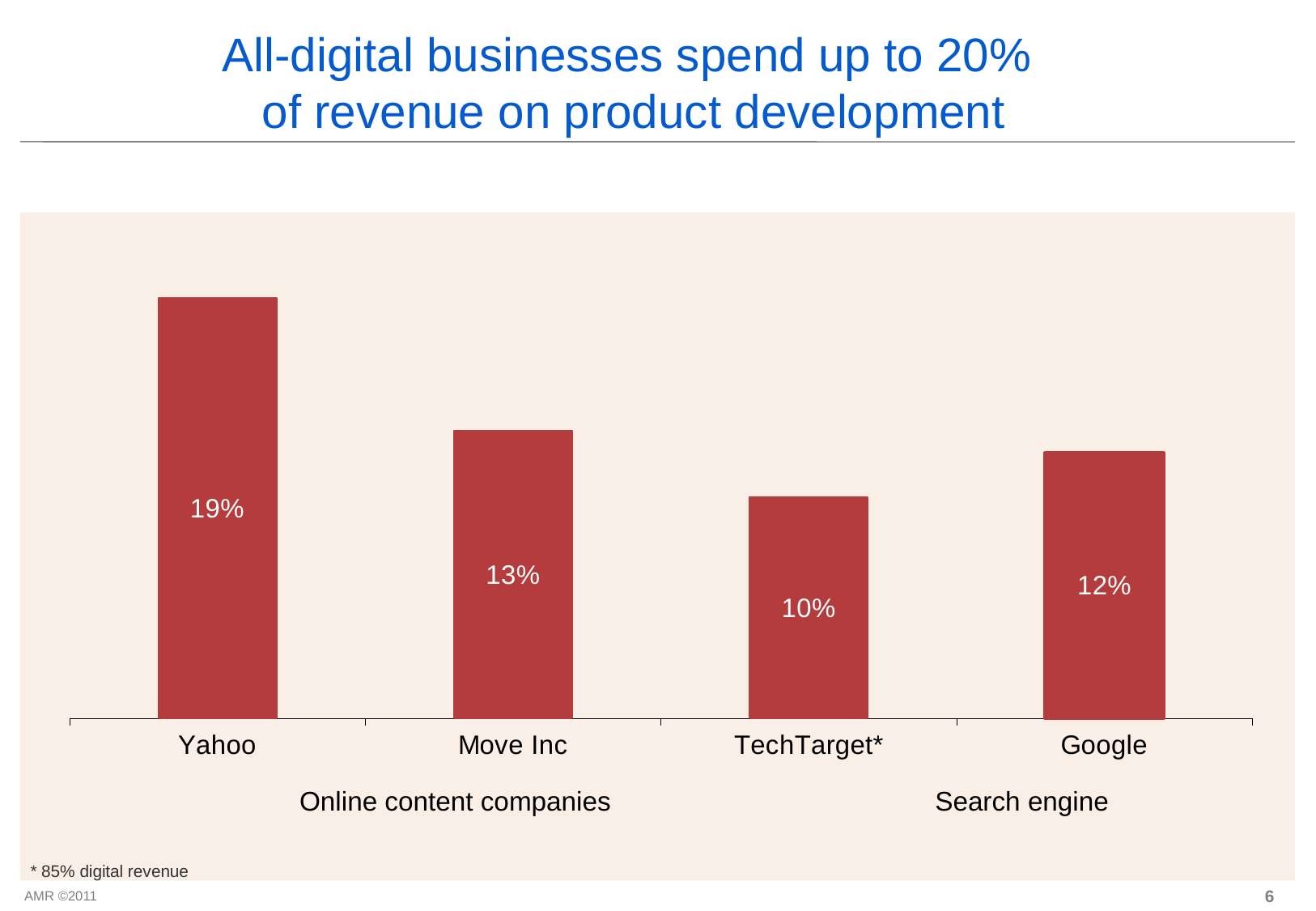
Which is larger, the value for Move Inc or the value for Google? Move Inc What is the value for Google? 12% What is the value for Yahoo? 19% What is the value for Move Inc? 13% What is the difference between the values for Yahoo and Google? 7% Which company has the highest value? Yahoo What kind of chart is shown on the slide? Bar chart What is the difference between the values for Move Inc and TechTarget*? 3% Which group label covers Yahoo, Move Inc and TechTarget*? Online content companies How many companies are shown in the chart? 4 Which company has the lowest value? TechTarget* What is the value for TechTarget*? 10%